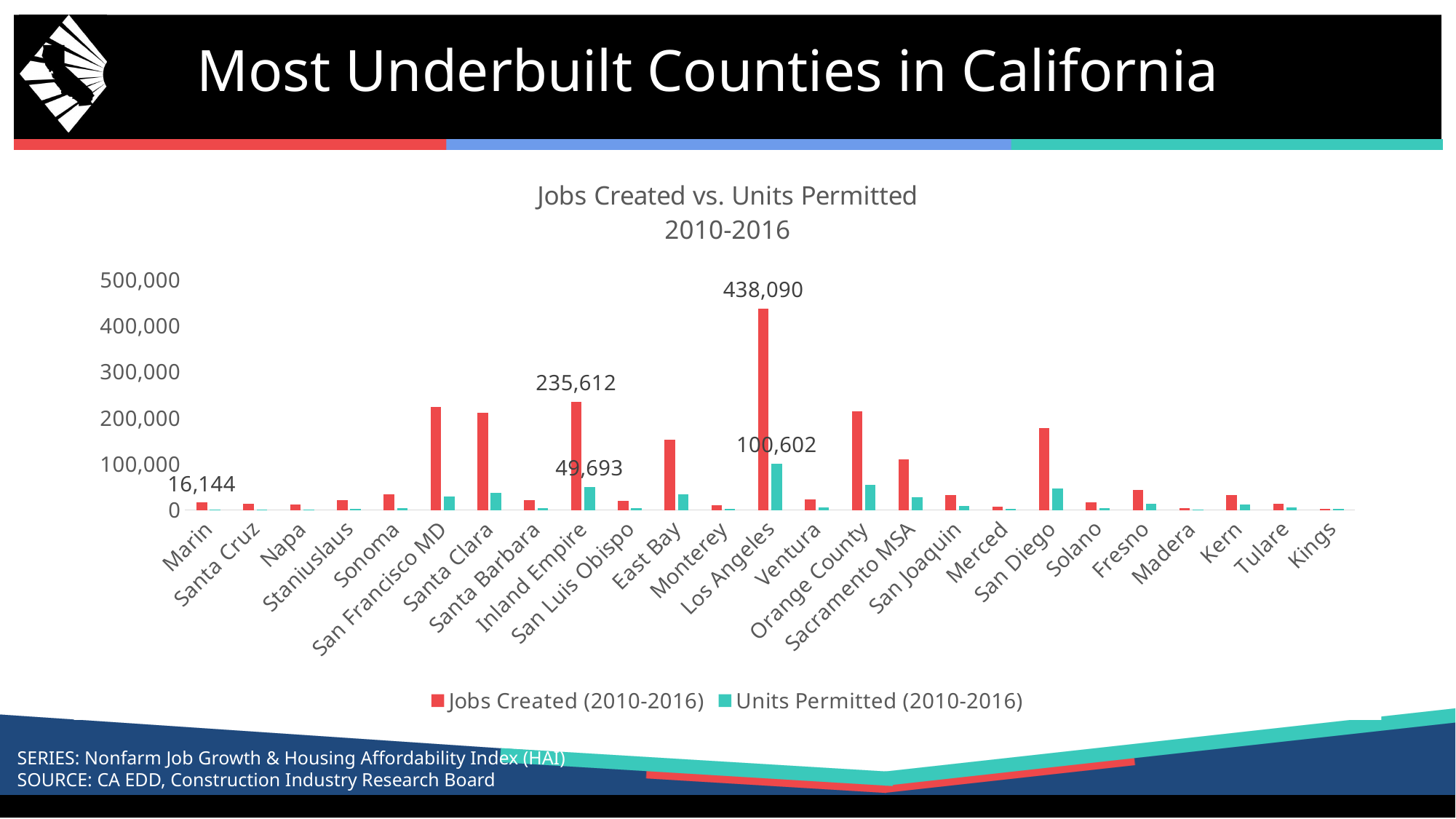
What is the value of Jobs Created (2010-2016) for Los Angeles? 438,090 Is the Jobs Created (2010-2016) value for San Francisco MD greater or less than 200,000? greater What is the value of Units Permitted (2010-2016) for the Inland Empire? 49,693 What is the title of the chart? Jobs Created vs. Units Permitted 2010-2016 What is the value of Units Permitted (2010-2016) for Los Angeles? 100,602 How many series does the legend list? 2 What type of chart is shown on the slide? Bar chart How many counties/regions are shown on the x axis? 25 What is the value of Jobs Created (2010-2016) for Marin? 16,144 Which region has the highest value for Jobs Created (2010-2016)? Los Angeles What is the value of Jobs Created (2010-2016) for the Inland Empire? 235,612 What is the difference between Jobs Created and Units Permitted for Los Angeles? 337,488